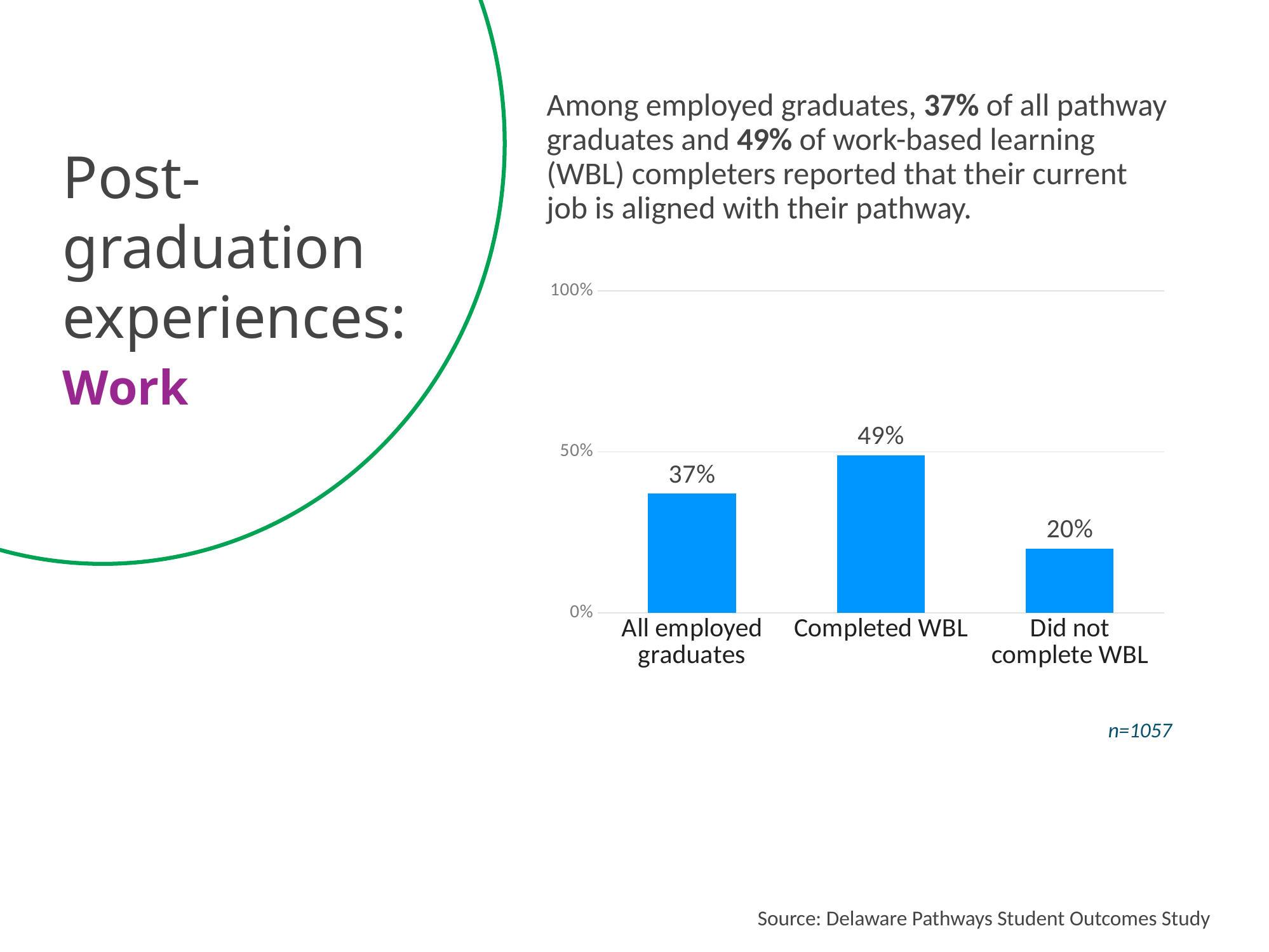
Which category has the lowest value? Did not complete WBL What kind of chart is shown on the slide? bar chart Which category has the highest value? Completed WBL What percentage is shown for Did not complete WBL? 20% What sample size (n) is noted below the chart? n=1057 What is the difference between the values for Completed WBL and All employed graduates? 12% What percentage is shown for Completed WBL? 49% Is the value for Completed WBL greater or less than 50%? less Which is larger, the value for All employed graduates or the value for Did not complete WBL? All employed graduates How many categories are shown on the x axis? 3 What percentage is shown for All employed graduates? 37% What is the difference between the values for Completed WBL and Did not complete WBL? 29%